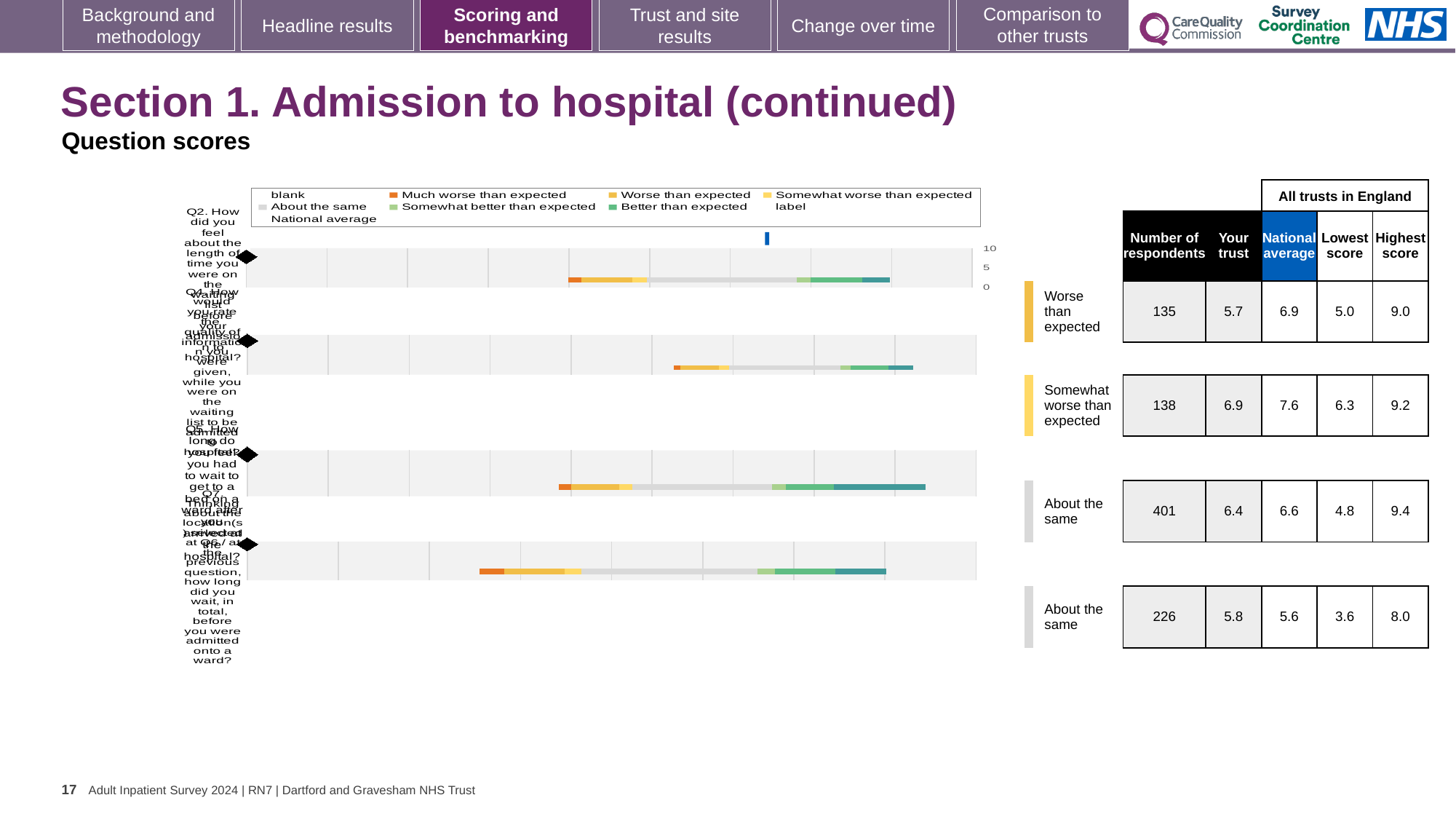
What is the heading above the 'National average', 'Lowest score' and 'Highest score' columns in the table beside the chart? All trusts in England In the table beside the chart, what is the highest score for the row with 401 respondents? 9.4 In the table beside the chart, for the row with 226 respondents, is the 'Your trust' score or the national average larger? Your trust In the table beside the chart, how many respondents are listed for the row rated 'Worse than expected'? 135 In the table beside the chart, what is the 'Your trust' score for the row rated 'Somewhat worse than expected'? 6.9 In the table beside the chart, what is the difference between the national average and the 'Your trust' score for the row rated 'Worse than expected'? 1.2 In the table beside the chart, which row has the largest number of respondents? About the same (401) In the table beside the chart, what is the national average for the row rated 'Worse than expected'? 6.9 In the table beside the chart, which row has the lowest 'Your trust' score? Worse than expected (5.7) In the table beside the chart, what is the lowest score for the row with 226 respondents? 3.6 What kind of chart is shown on the slide? bar chart How many question bars are plotted in the chart? 4